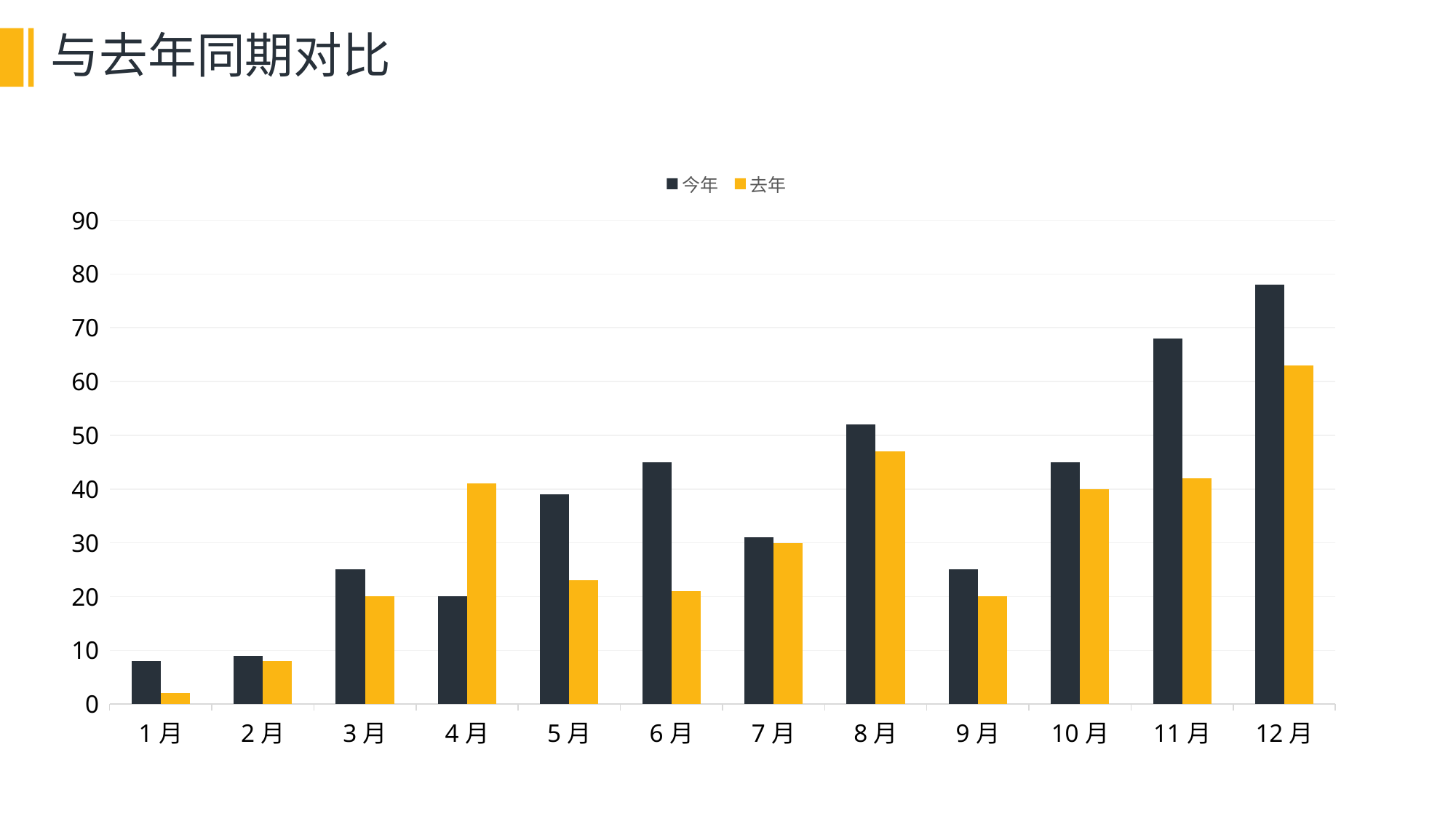
Which month has the lowest value for 去年? 1月 What is the title of the slide? 与去年同期对比 In 4月, which series has the larger value, 今年 or 去年? 去年 Is the value for 今年 in 12月 greater or less than 70? greater How many series does the legend list? 2 In 11月, which series has the larger value, 今年 or 去年? 今年 Is the value for 今年 in 8月 greater or less than 50? greater How many months are shown on the x axis? 12 Which month has the highest value for 今年? 12月 What kind of chart is shown on the slide? bar chart Is the value for 去年 in 6月 greater or less than 30? less Which month has the lowest value for 今年? 1月